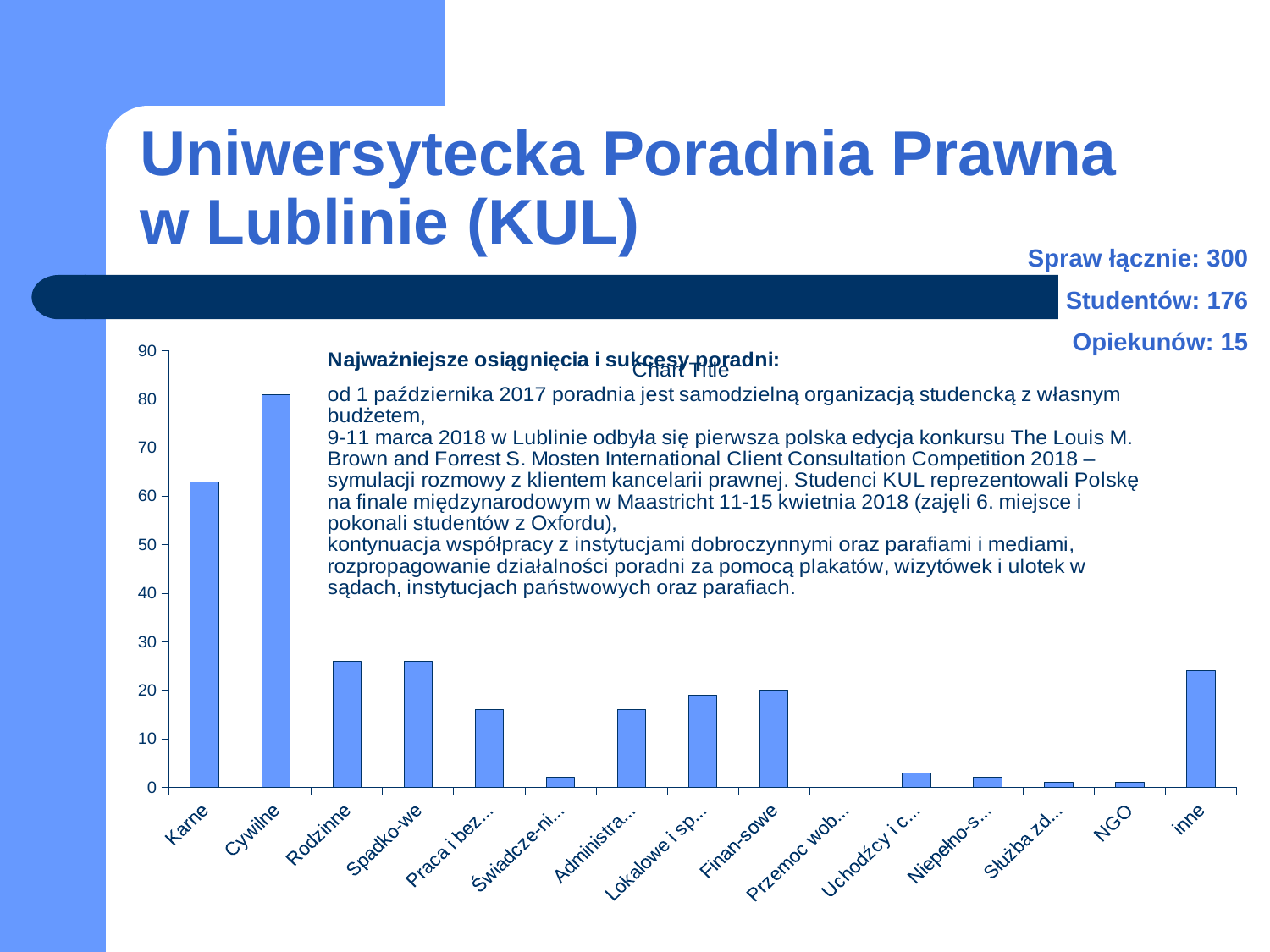
What is the title shown on the chart? Chart Title Which is larger, the value for Karne or the value for Cywilne? Cywilne Is the value for Rodzinne greater or less than 20? greater What kind of chart is shown on the slide? bar chart Is the value for NGO greater or less than 10? less Which is larger, the value for Karne or the value for inne? Karne How many categories are shown on the x axis of the chart? 15 Which is larger, the value for Cywilne or the value for Spadko-we? Cywilne Which category has the highest bar in the chart? Cywilne Is the value for Karne greater or less than 60? greater